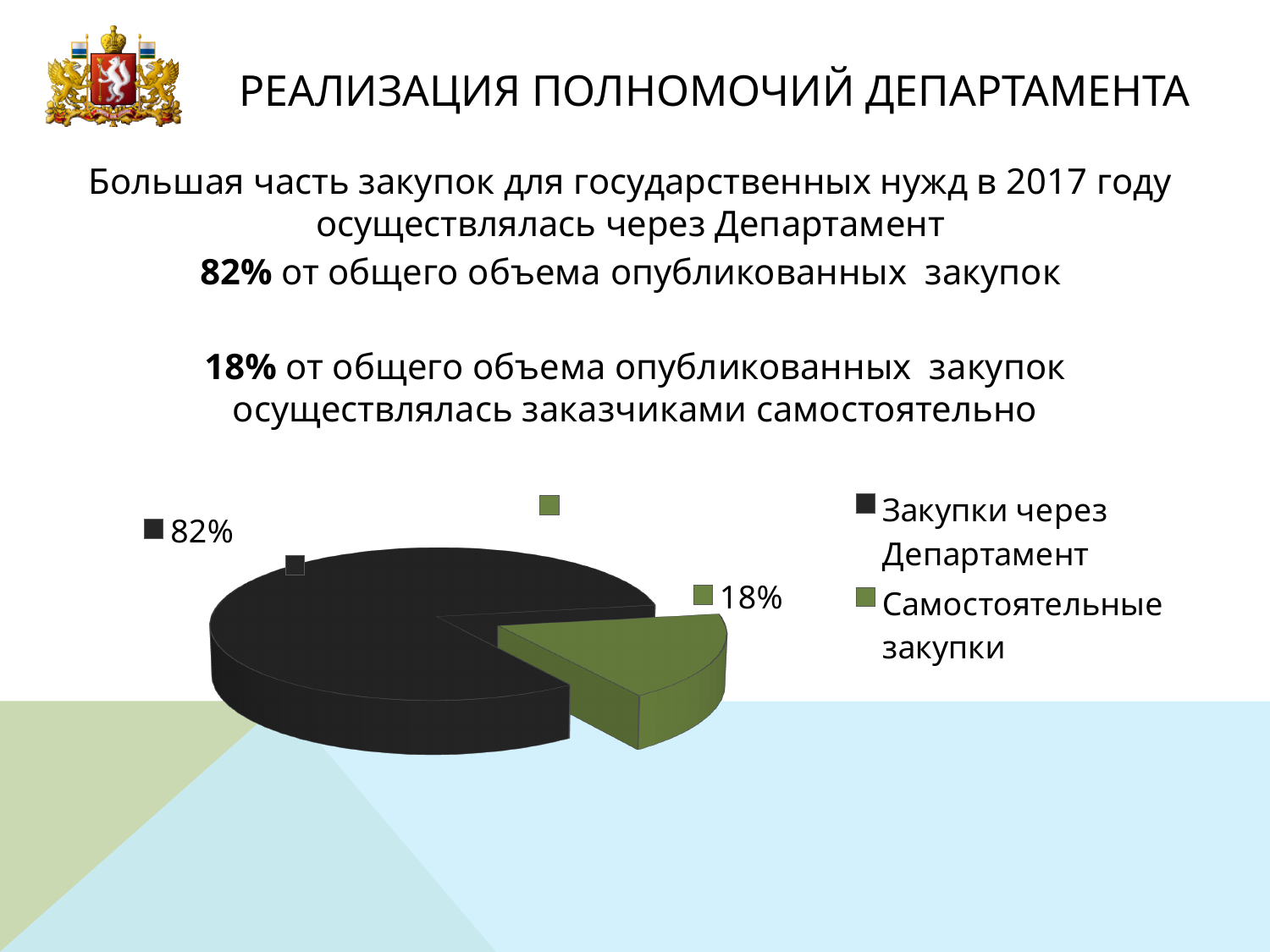
Which slice of the pie is the largest? Закупки через Департамент Which is larger: the share for "Закупки через Департамент" or the share for "Самостоятельные закупки"? Закупки через Департамент How many slices does the pie chart have? 2 What colour is the "Закупки через Департамент" slice? Black What share of the pie does "Закупки через Департамент" represent? 82% What kind of chart is shown on the slide? Pie chart What colour is the "Самостоятельные закупки" slice? Green What is the difference in percentage points between the "Закупки через Департамент" slice and the "Самостоятельные закупки" slice? 64 What share of the pie does "Самостоятельные закупки" represent? 18% Which slice of the pie is the smallest? Самостоятельные закупки How many entries does the legend list? 2